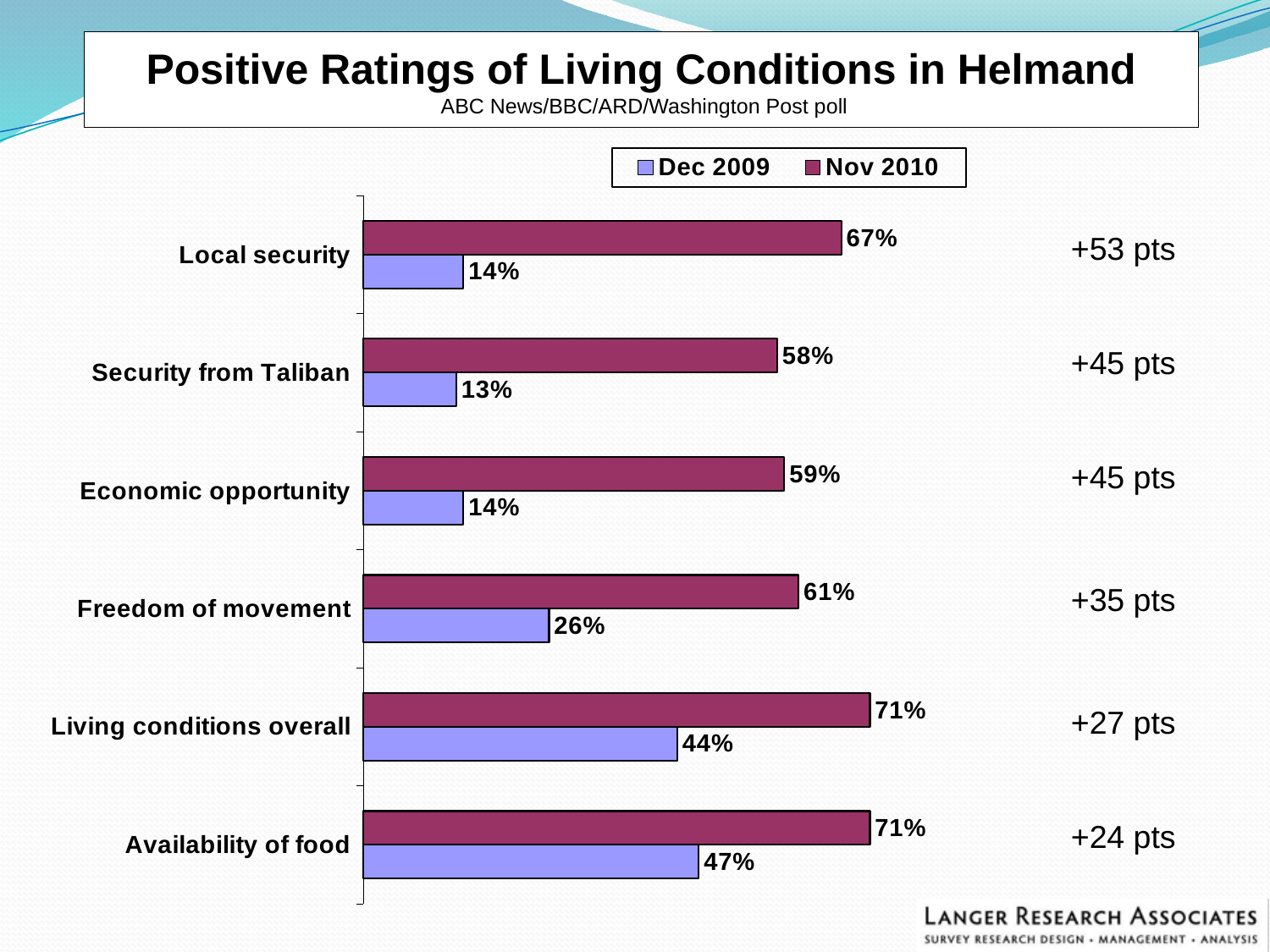
What was the Dec 2009 positive rating for Freedom of movement? 26% What is the difference between the Nov 2010 and Dec 2009 ratings for Living conditions overall? 27 pts What kind of chart is shown on the slide? Bar chart How many series does the legend list? 2 What was the Nov 2010 positive rating for Local security? 67% What was the Dec 2009 positive rating for Availability of food? 47% How many categories are shown in the chart? 6 Which poll is cited in the chart's subtitle? ABC News/BBC/ARD/Washington Post poll Which category had the lowest Nov 2010 positive rating? Security from Taliban Which is larger: the Nov 2010 rating for Economic opportunity or the Nov 2010 rating for Freedom of movement? Freedom of movement Which category had the lowest Dec 2009 positive rating? Security from Taliban Which category showed the largest point gain from Dec 2009 to Nov 2010? Local security (+53 pts)